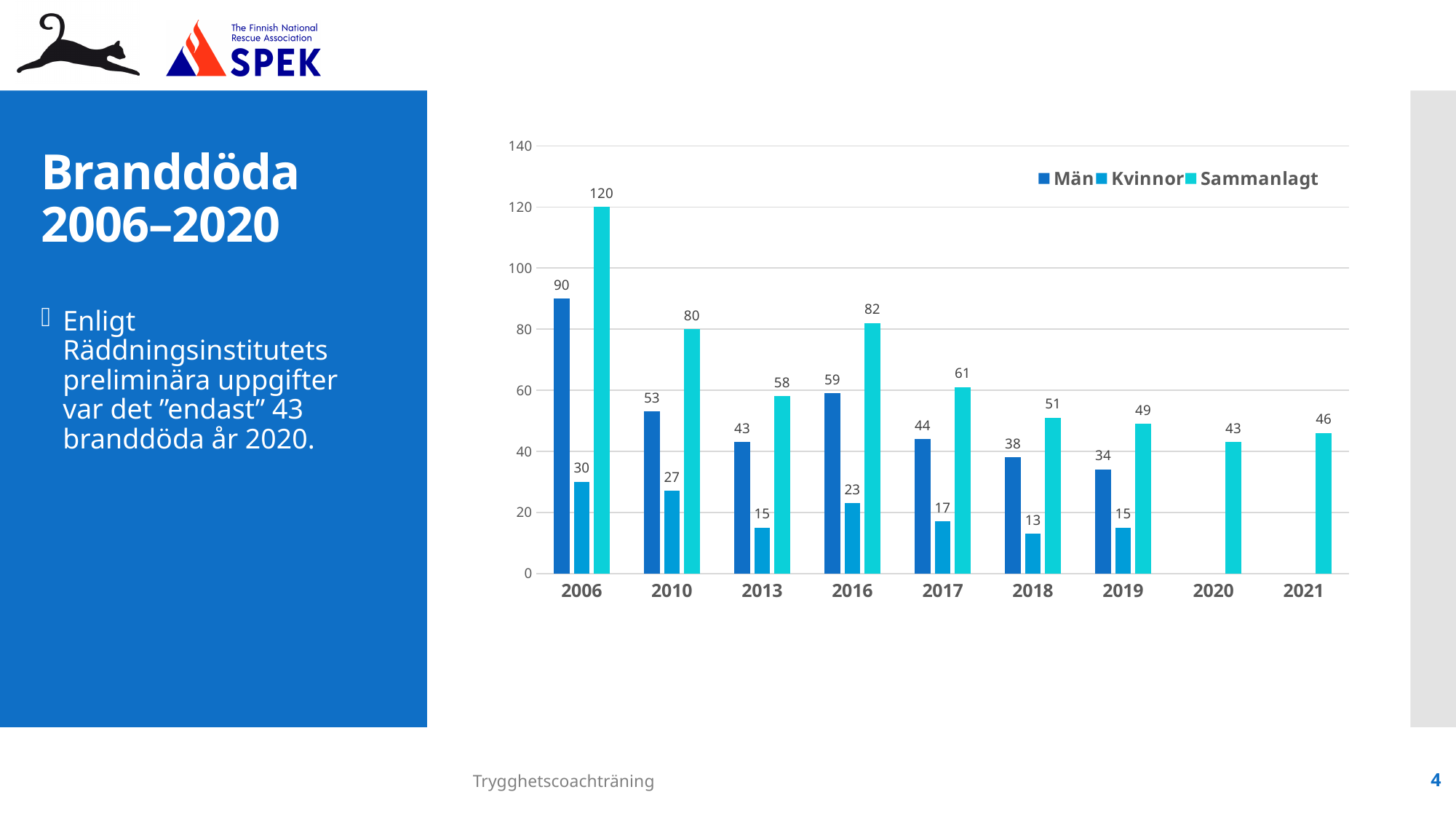
How many series does the legend list? 3 What is the value for Män in 2006? 90 Which year has the highest Sammanlagt value? 2006 Which is larger, the Män value for 2013 or the Män value for 2017? 2017 Which year has the lowest Kvinnor value? 2018 Which series are listed in the legend? Män, Kvinnor, Sammanlagt What is the value for Sammanlagt in 2021? 46 Is the Sammanlagt value for 2016 greater or less than 80? greater What is the difference between the Sammanlagt values for 2006 and 2010? 40 How many years are shown on the x axis? 9 What kind of chart is shown on the slide? bar chart What is the value for Kvinnor in 2018? 13